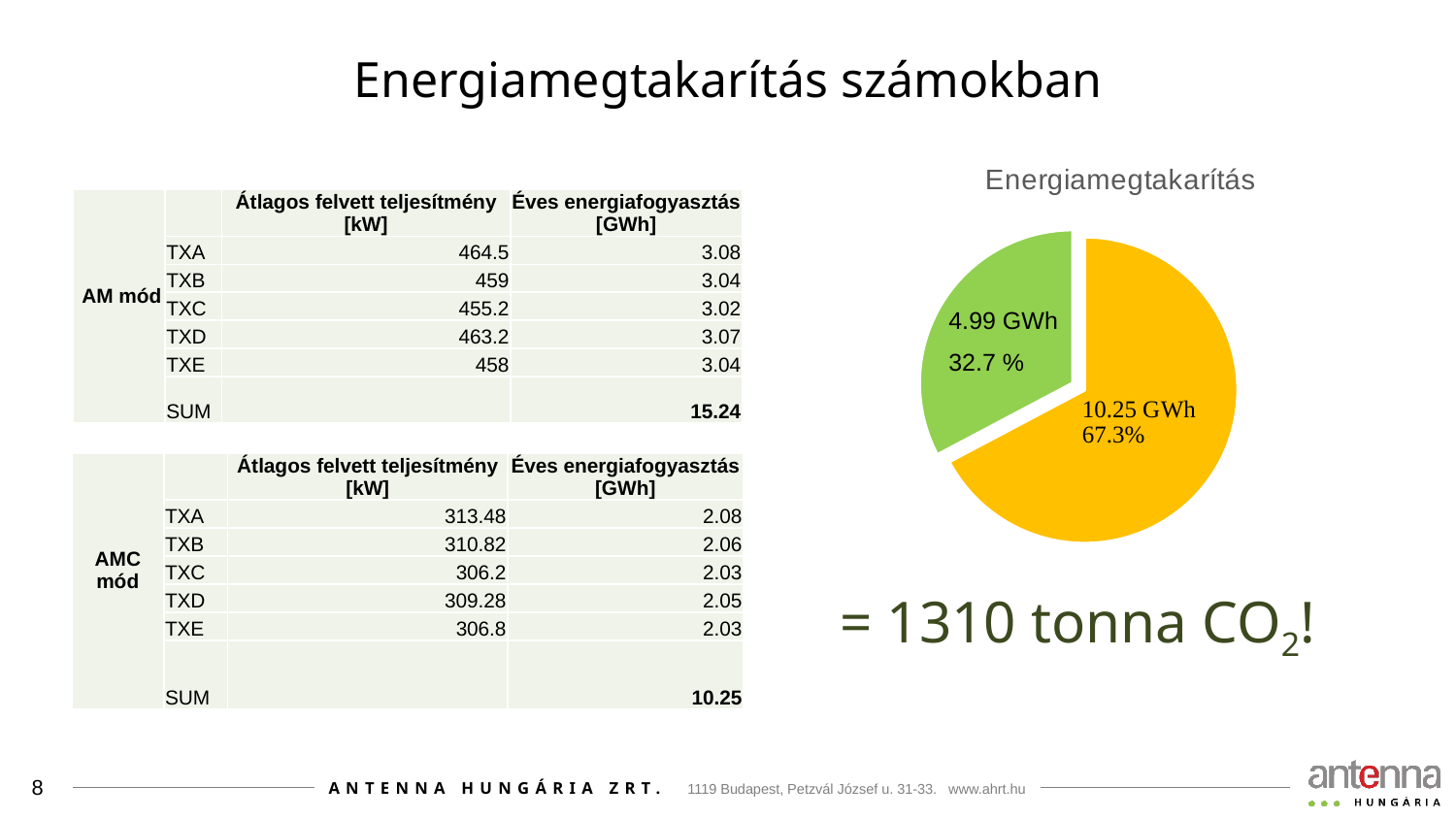
Is the yellow slice or the green slice of the pie chart larger? the yellow slice Which slice of the pie chart is the smallest? the green slice (4.99 GWh) What share of the pie does the green slice represent? 32.7 % Which slice of the pie chart is the largest? the yellow slice (10.25 GWh) What kind of chart is shown on the slide? pie chart What value in GWh is labelled on the yellow slice of the pie chart? 10.25 GWh How many slices does the pie chart have? 2 What share of the pie does the yellow slice represent? 67.3% What is the difference in GWh between the yellow slice and the green slice of the pie chart? 5.26 GWh What is the title of the pie chart? Energiamegtakarítás What value in GWh is labelled on the green slice of the pie chart? 4.99 GWh What colour is the slice labelled 4.99 GWh in the pie chart? green